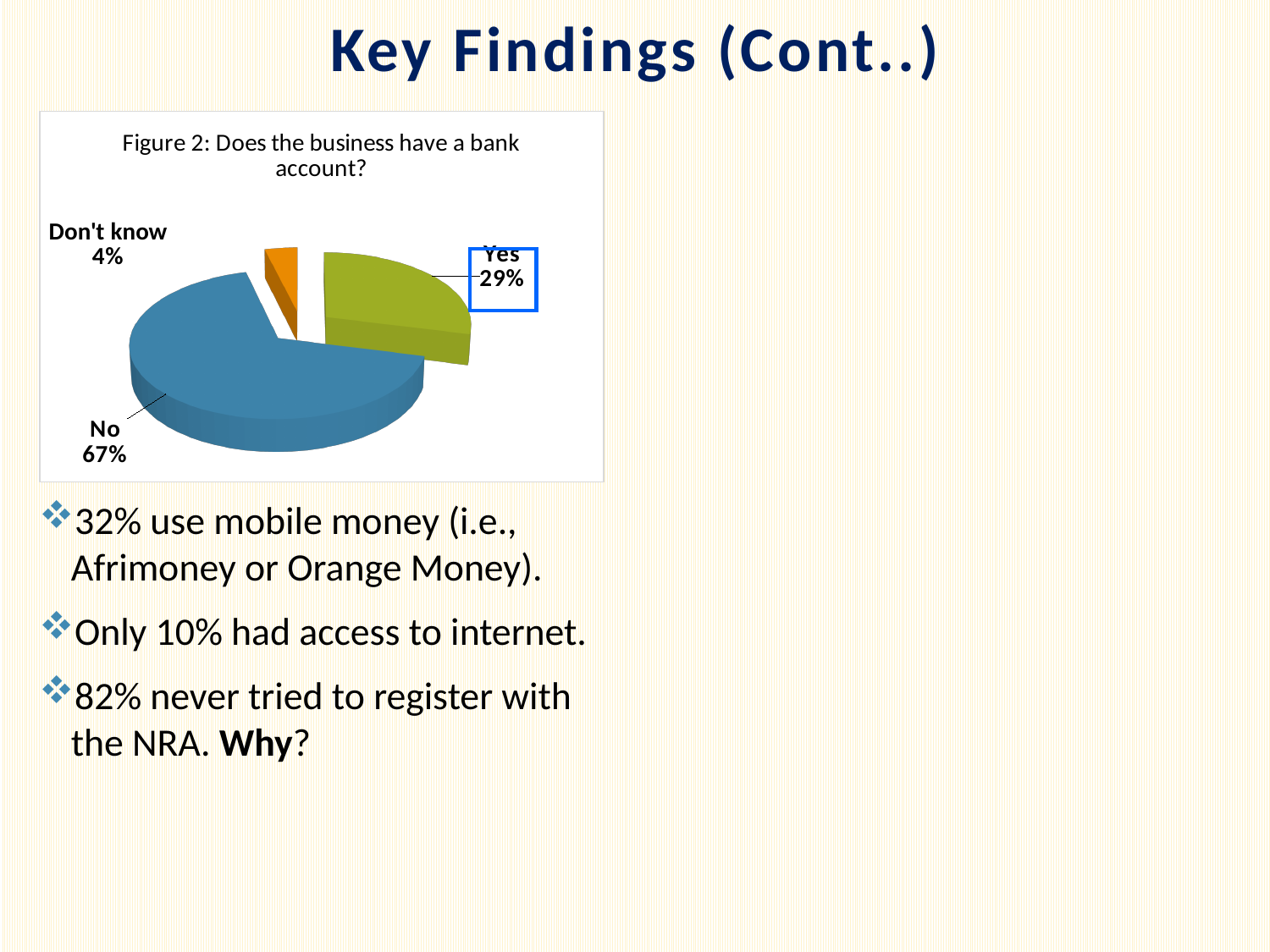
What percentage of businesses answered "Don't know"? 4% What colour is the "No" slice of the pie? Blue What kind of chart is shown on the slide? Pie chart What is the difference in percentage points between the "No" and "Yes" slices? 38 What is the combined share of the "Yes" and "Don't know" slices? 33% Which response has the smallest share of the pie? Don't know How many slices does the pie chart have? 3 Which response has the largest share of the pie? No What percentage of businesses answered "No" to having a bank account? 67% What is the title of the chart? Figure 2: Does the business have a bank account? Which is larger, the "Yes" slice or the "Don't know" slice? Yes What percentage of businesses answered "Yes" to having a bank account? 29%